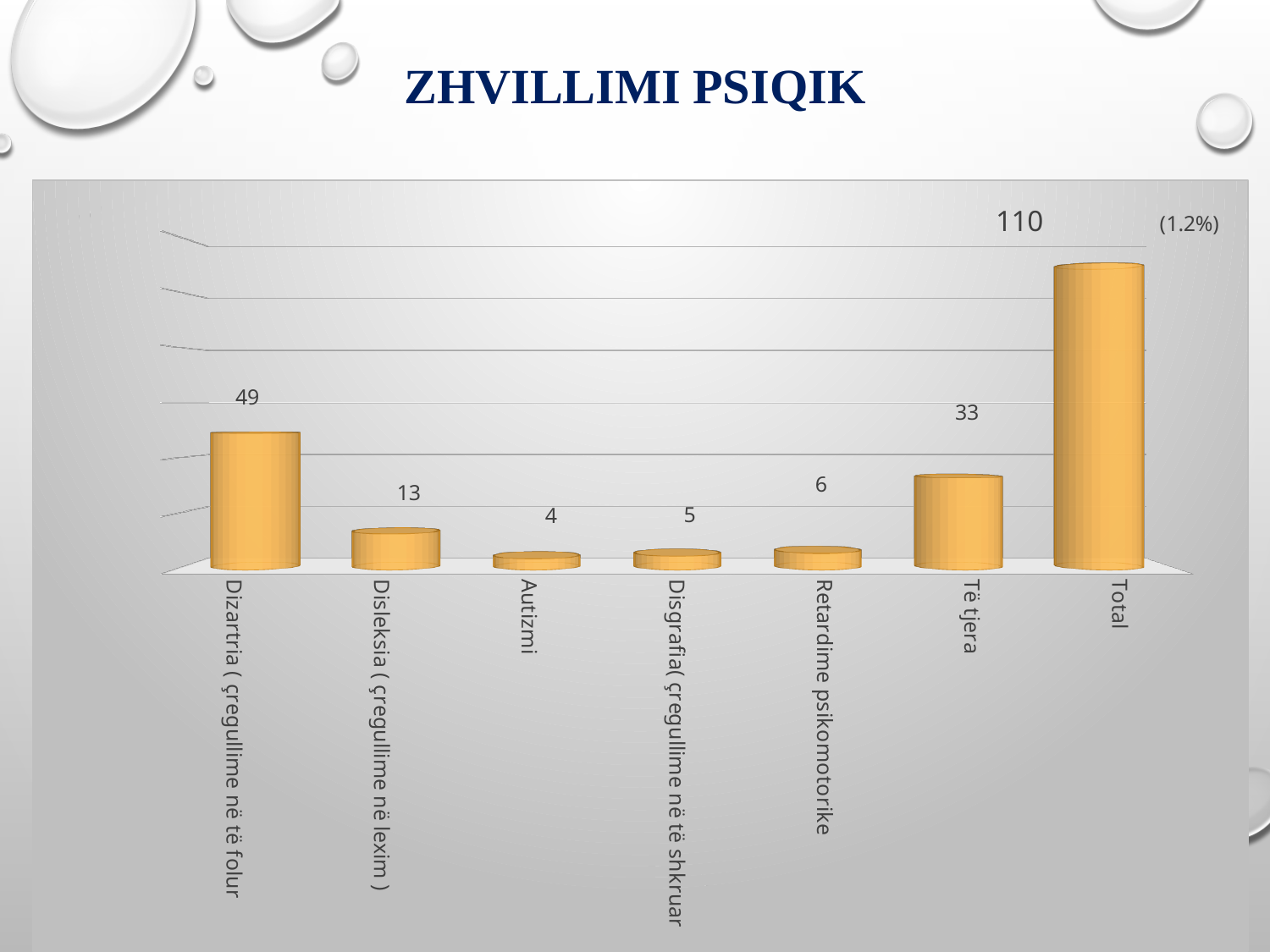
What is the value for Autizmi? 4 Which category has the lowest value? Autizmi What is the value for Total? 110 What is the value for Dizartria (çregullime në të folur)? 49 What is the difference between the values for Dizartria (çregullime në të folur) and Të tjera? 16 What kind of chart is shown on the slide? Bar chart Which is larger, the value for Disgrafia (çregullime në të shkruar) or the value for Disleksia (çregullime në lexim)? Disleksia (çregullime në lexim) What is the value for Retardime psikomotorike? 6 Excluding Total, which category has the highest value? Dizartria (çregullime në të folur) What is the value for Të tjera? 33 What is the value for Disleksia (çregullime në lexim)? 13 How many categories are shown on the x axis? 7